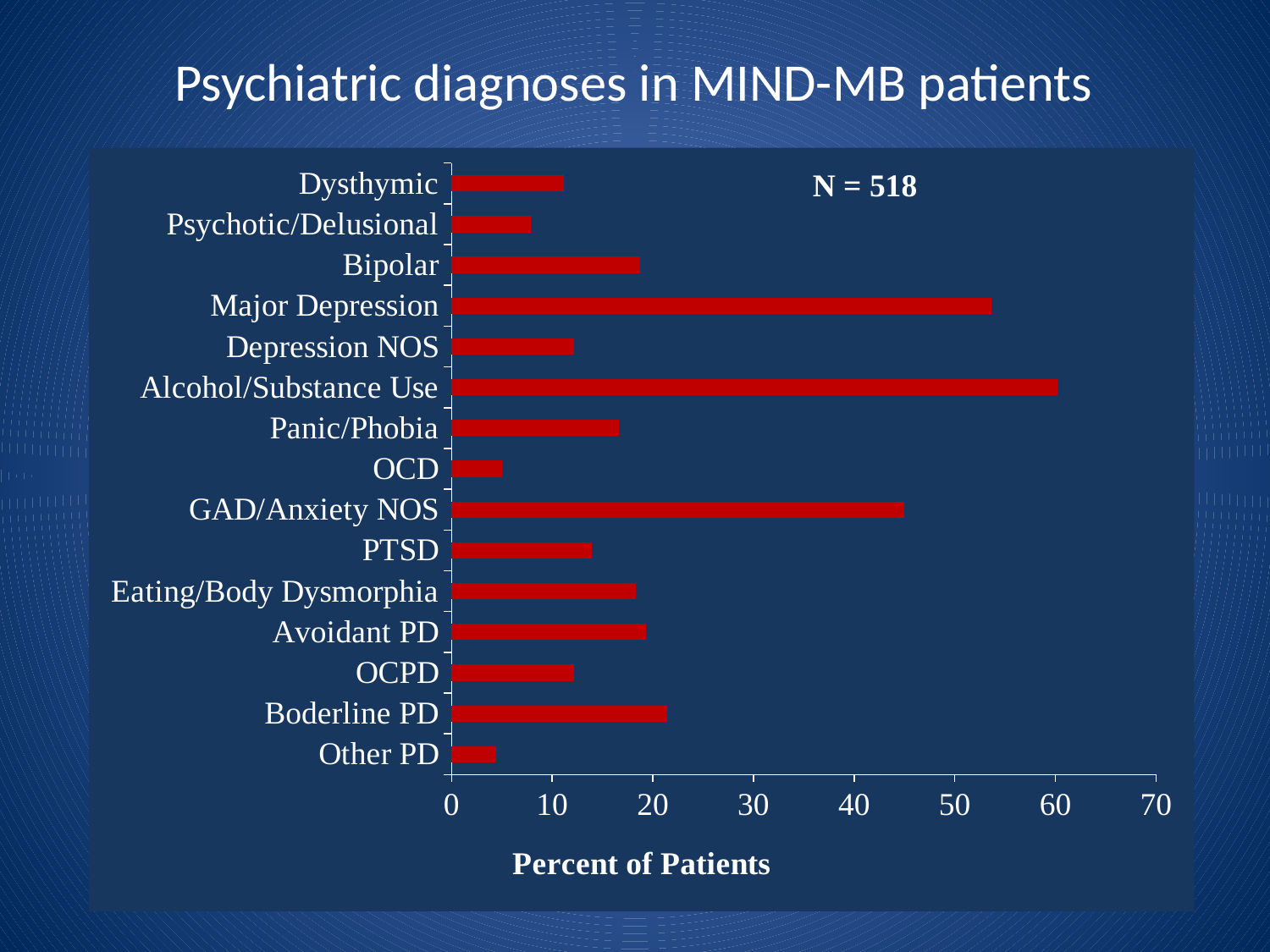
Which is larger, the value for Panic/Phobia or the value for OCD? Panic/Phobia Which is larger, the value for Major Depression or the value for GAD/Anxiety NOS? Major Depression How many diagnosis categories are plotted in the chart? 15 What sample size (N) is shown on the chart? N = 518 Which diagnosis has the highest percent of patients? Alcohol/Substance Use Is the value for Psychotic/Delusional greater or less than 10? less Is the value for PTSD greater or less than 20? less Is the value for Major Depression greater or less than 50? greater What kind of chart is shown on the slide? bar chart What is the label of the horizontal axis? Percent of Patients